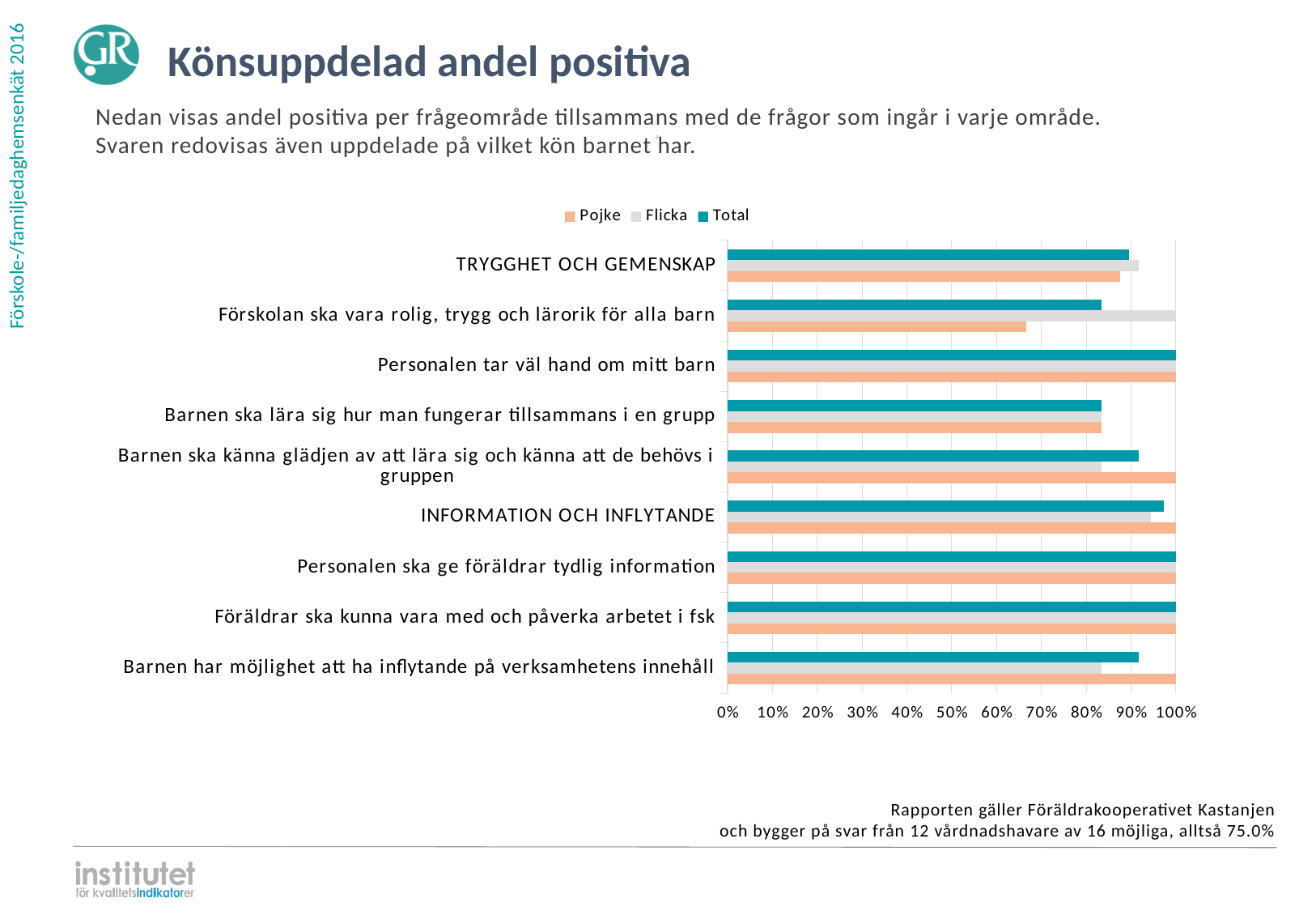
How many categories are plotted on the y axis of the chart? 9 Which category has the lowest Pojke value? Förskolan ska vara rolig, trygg och lärorik för alla barn What kind of chart is shown on the slide? bar chart Is the Flicka value for 'Barnen har möjlighet att ha inflytande på verksamhetens innehåll' greater or less than 90%? less What is the Total value for 'Föräldrar ska kunna vara med och påverka arbetet i fsk'? 100% For 'Förskolan ska vara rolig, trygg och lärorik för alla barn', which is larger: the Pojke value or the Flicka value? Flicka What is the Pojke value for 'Personalen tar väl hand om mitt barn'? 100% Is the Pojke value for 'Förskolan ska vara rolig, trygg och lärorik för alla barn' greater or less than 80%? less What are the three legend entries of the chart? Pojke, Flicka, Total How many series does the legend list? 3 What is the Flicka value for 'Förskolan ska vara rolig, trygg och lärorik för alla barn'? 100% Is the Total value for 'TRYGGHET OCH GEMENSKAP' greater or less than 80%? greater